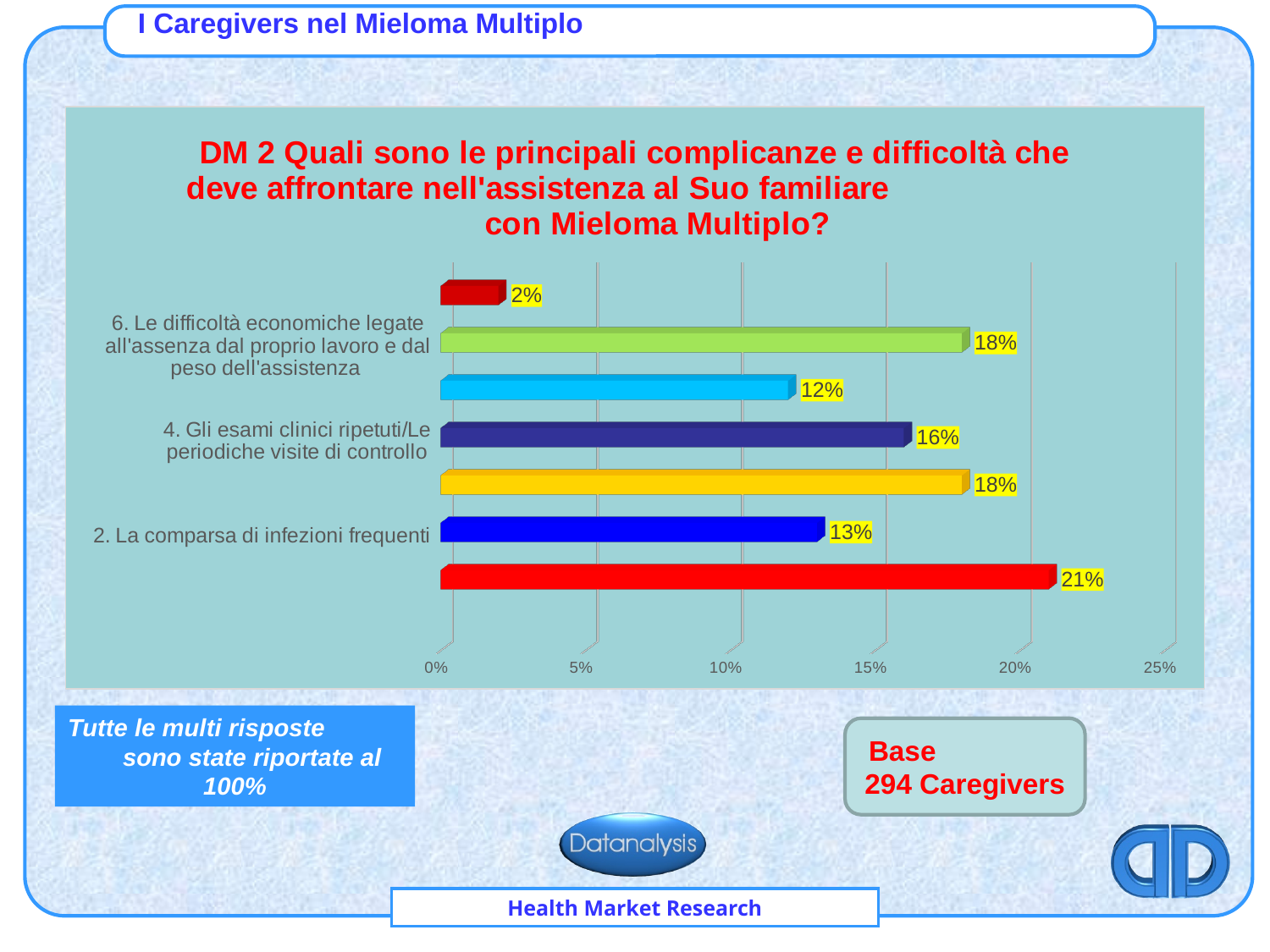
What kind of chart is shown on the slide? bar chart Is the value for "4. Gli esami clinici ripetuti/Le periodiche visite di controllo" greater or less than 15%? greater What is the lowest value shown in the chart? 2% What is the base (number of caregivers) stated on the slide for the chart? 294 Caregivers What is the value for "4. Gli esami clinici ripetuti/Le periodiche visite di controllo"? 16% How many bars are plotted in the chart? 7 What is the value for "6. Le difficoltà economiche legate all'assenza dal proprio lavoro e dal peso dell'assistenza"? 18% Which has a larger value: "6. Le difficoltà economiche legate all'assenza dal proprio lavoro e dal peso dell'assistenza" or "2. La comparsa di infezioni frequenti"? 6. Le difficoltà economiche legate all'assenza dal proprio lavoro e dal peso dell'assistenza What is the maximum value shown on the x axis of the chart? 25% What is the highest value shown in the chart? 21% What is the difference between the value for "4. Gli esami clinici ripetuti/Le periodiche visite di controllo" and the value for "2. La comparsa di infezioni frequenti"? 3% What is the value for "2. La comparsa di infezioni frequenti"? 13%